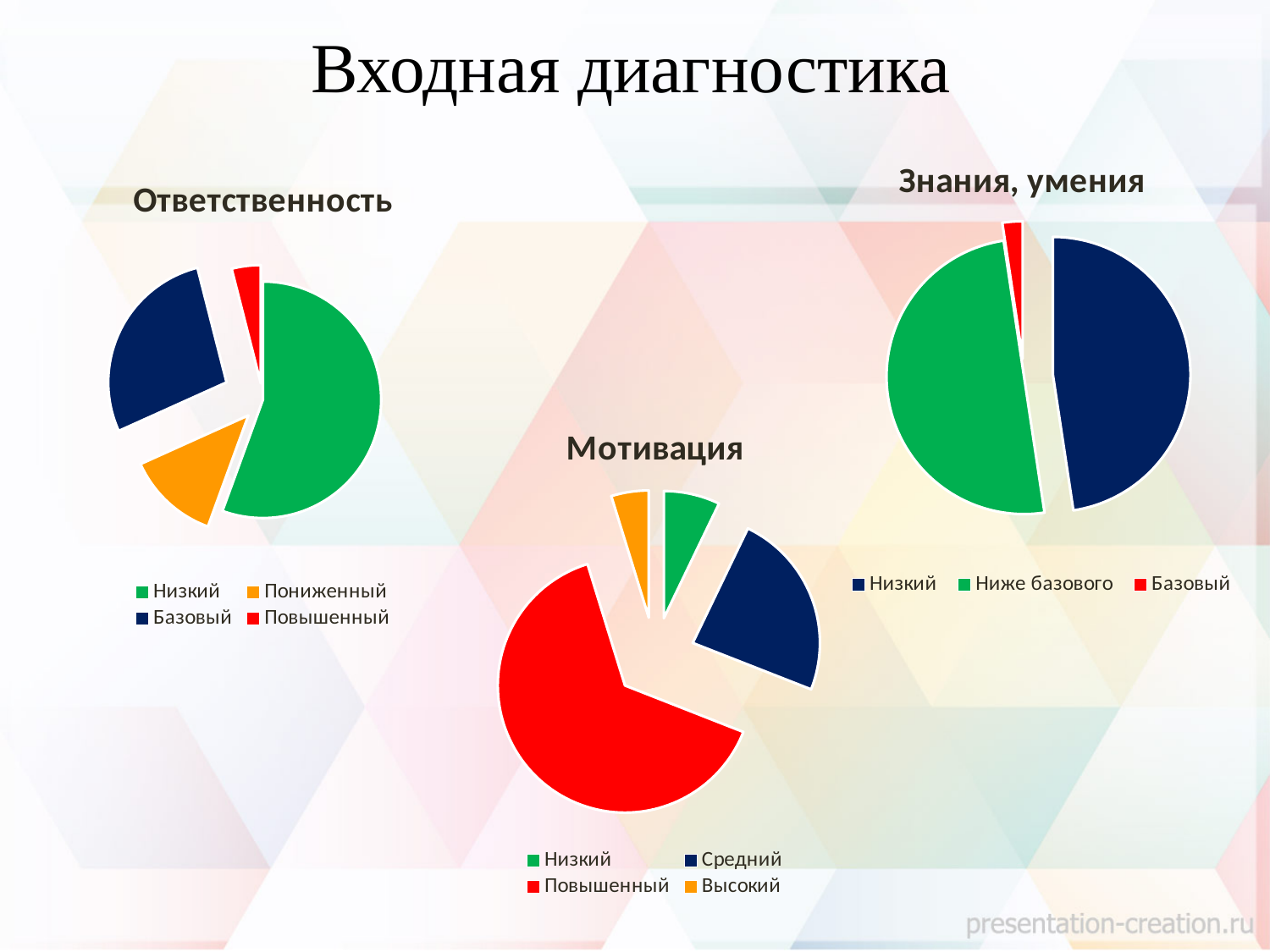
How many categories does the legend of the "Знания, умения" chart list? 3 In the "Знания, умения" chart, which category has the smallest slice? Базовый In the "Ответственность" chart, which slice is larger: Базовый or Пониженный? Базовый How many categories does the legend of the "Мотивация" chart list? 4 In the "Мотивация" chart, which slice is larger: Средний or Низкий? Средний In the "Знания, умения" chart, what colour is the Ниже базового slice? green How many pie charts are shown on the slide? 3 In the "Ответственность" chart, which category has the smallest slice? Повышенный What kind of chart is the "Ответственность" chart? pie chart In the "Ответственность" chart, which category has the largest slice? Низкий How many categories does the legend of the "Ответственность" chart list? 4 In the "Мотивация" chart, which category has the largest slice? Повышенный